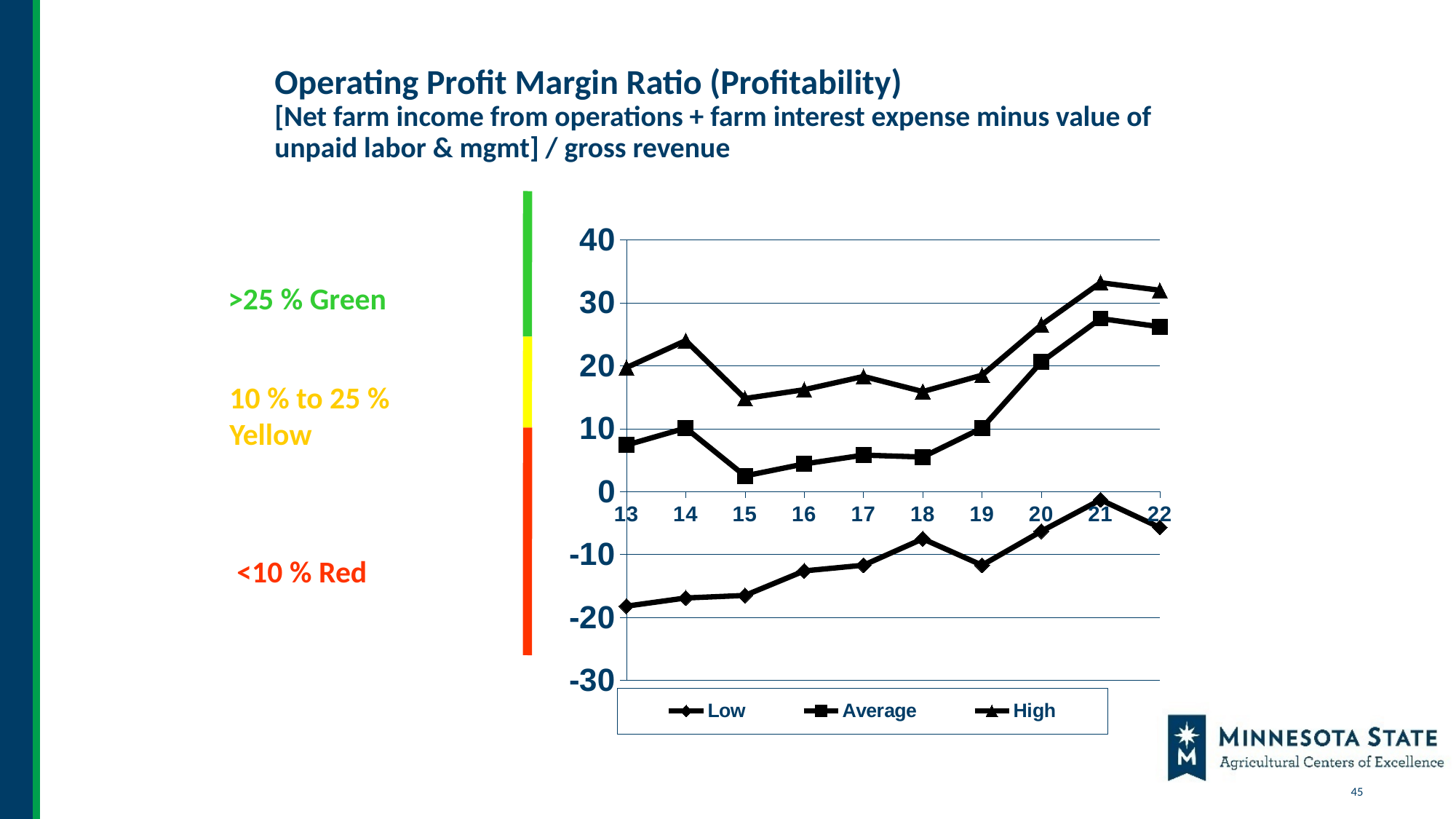
What are the three series names listed in the chart legend? Low, Average, High Which is larger for the High series: the value in year 14 or the value in year 15? year 14 What kind of chart is shown on the slide? line chart Is the value for the High series in year 15 greater or less than 20? less Does the Low series rise or fall from year 13 to year 18? rise Is the value for the Average series in year 15 greater or less than 10? less How many years are plotted along the x axis of the chart? 10 In which year does the High series reach its highest value? 21 Is the value for the High series in year 21 greater or less than 30? greater How many series does the chart legend list? 3 In which year does the Average series reach its lowest value? 15